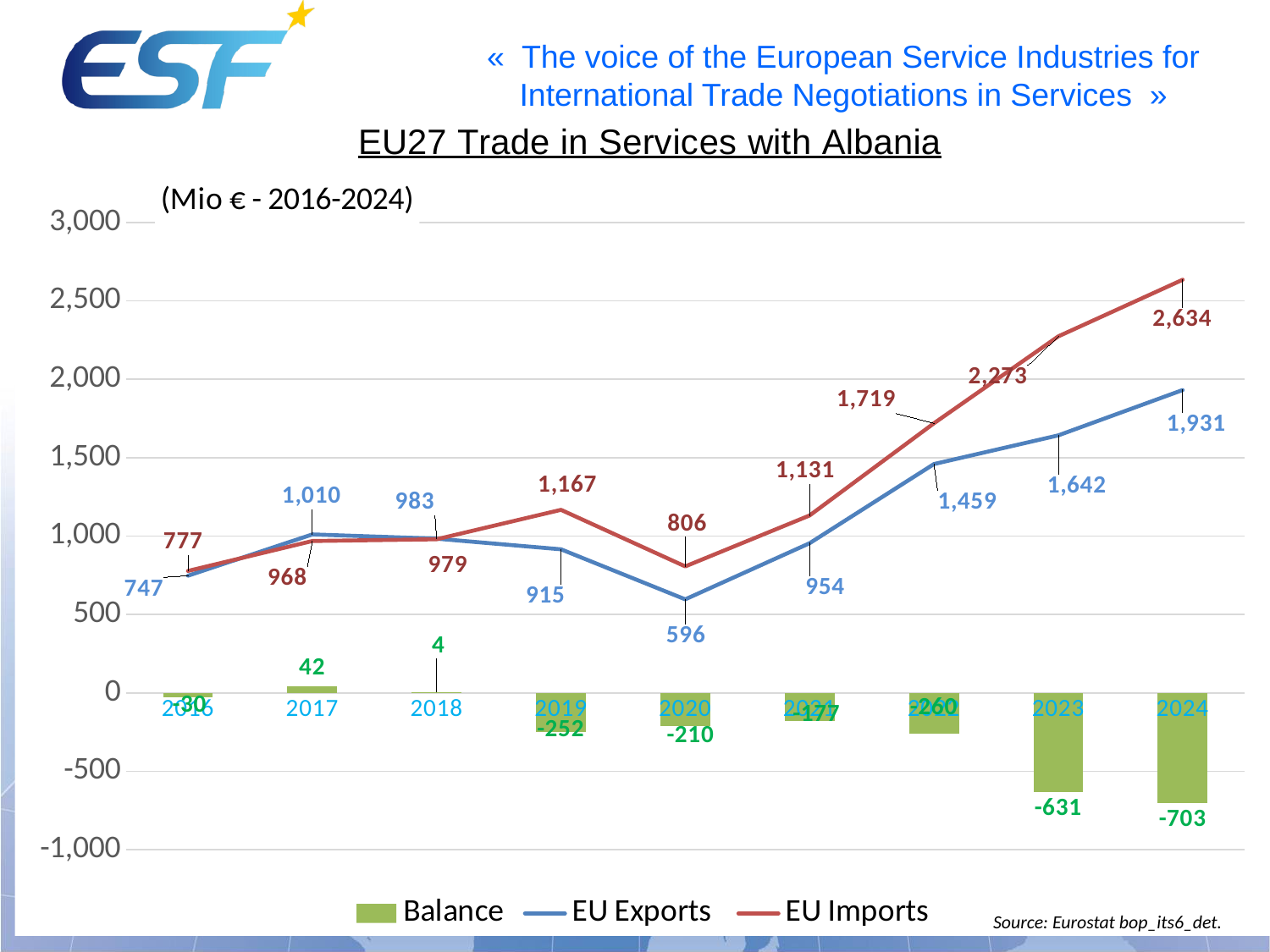
What is the Balance value shown for 2023? -631 What is the value of EU Imports in 2024? 2,634 In which year are EU Exports lowest? 2020 Is the value for EU Imports in 2023 greater or less than 2,000? greater What is the difference between EU Imports and EU Exports in 2024? 703 What is the value of EU Exports in 2020? 596 What kind of chart is this? Combined bar and line chart How many years are shown on the x axis? 9 In 2017, which is larger: EU Exports or EU Imports? EU Exports In which year are EU Imports highest? 2024 How many series does the legend list? 3 Do EU Imports rise or fall from 2020 to 2024? rise